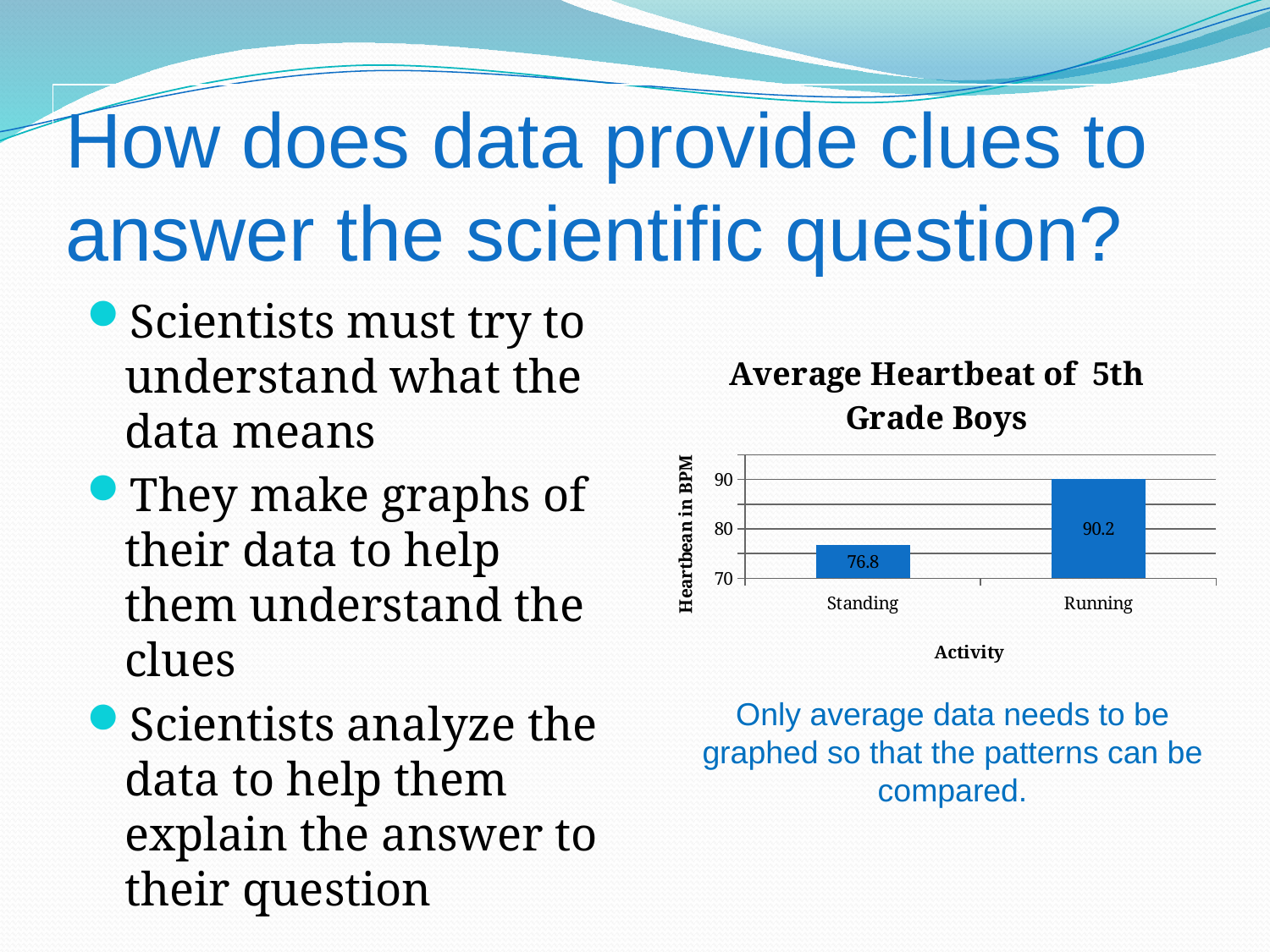
What is the average heartbeat in BPM for Running? 90.2 What is the average heartbeat in BPM for Standing? 76.8 Which has a larger average heartbeat, Standing or Running? Running Which activity has the lowest average heartbeat? Standing How many activities are shown on the chart? 2 Is the value for Running greater or less than 90? greater What is the difference in average heartbeat between Running and Standing? 13.4 What is the label of the vertical axis of the chart? Heartbeat in BPM Is the value for Standing greater or less than 80? less Which activity has the highest average heartbeat? Running What is the title of the chart? Average Heartbeat of 5th Grade Boys What kind of chart is shown on the slide? bar chart